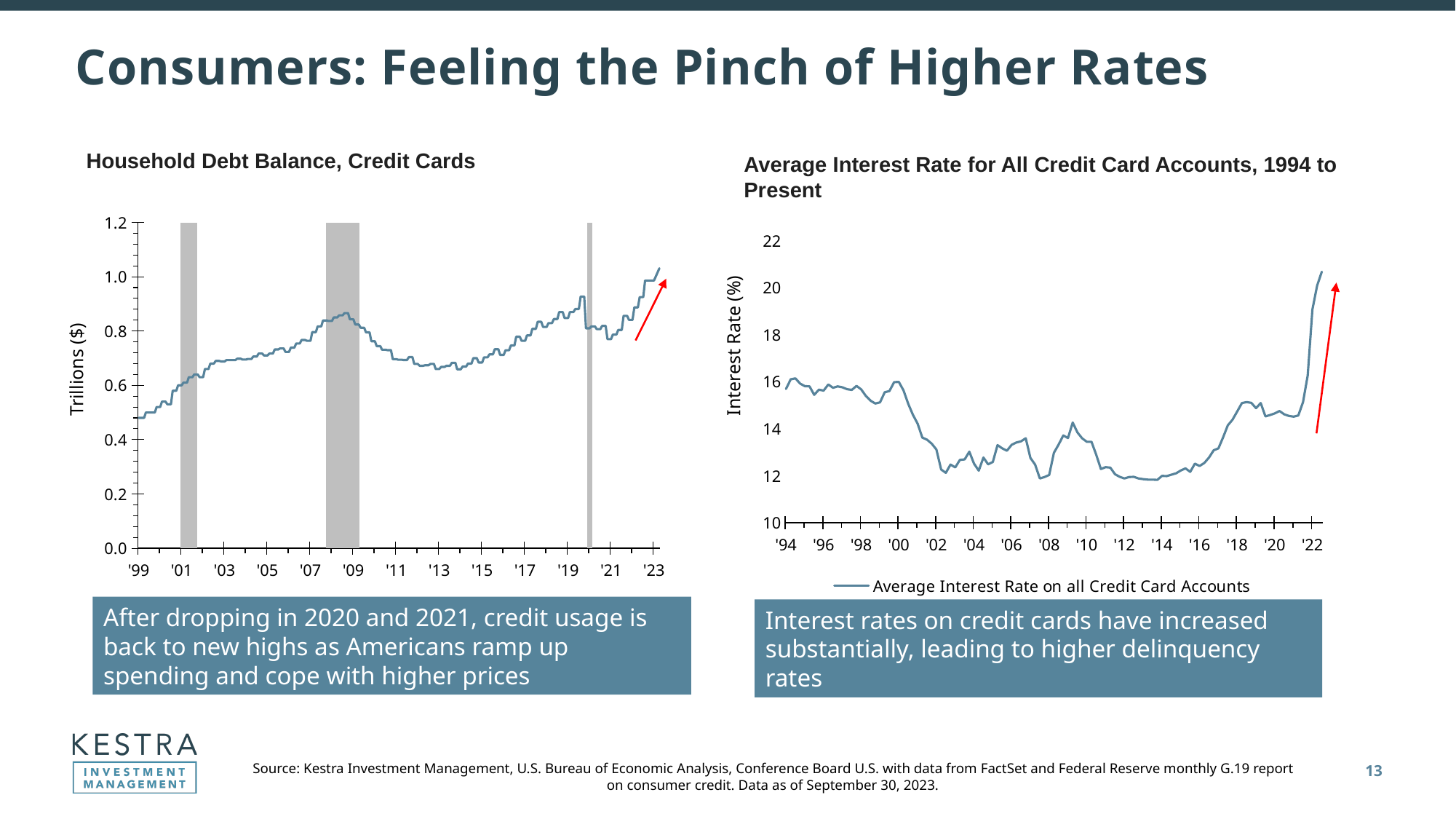
In the 'Household Debt Balance, Credit Cards' chart, do values rise or fall between '21 and '23? rise How many series does the legend of the 'Average Interest Rate for All Credit Card Accounts, 1994 to Present' chart list? 1 In the 'Household Debt Balance, Credit Cards' chart, is the value in '13 greater or less than 0.8? less In the 'Average Interest Rate for All Credit Card Accounts, 1994 to Present' chart, do values rise or fall between '14 and '22? rise In the 'Household Debt Balance, Credit Cards' chart, do values rise or fall between '09 and '13? fall What is the y-axis label of the 'Household Debt Balance, Credit Cards' chart? Trillions ($) In the 'Household Debt Balance, Credit Cards' chart, is the value at the end of the series in '23 greater or less than 0.8? greater In the 'Average Interest Rate for All Credit Card Accounts, 1994 to Present' chart, is the value in '14 greater or less than 14? less What kind of chart is the 'Average Interest Rate for All Credit Card Accounts, 1994 to Present' chart? line chart What kind of chart is the 'Household Debt Balance, Credit Cards' chart? line chart